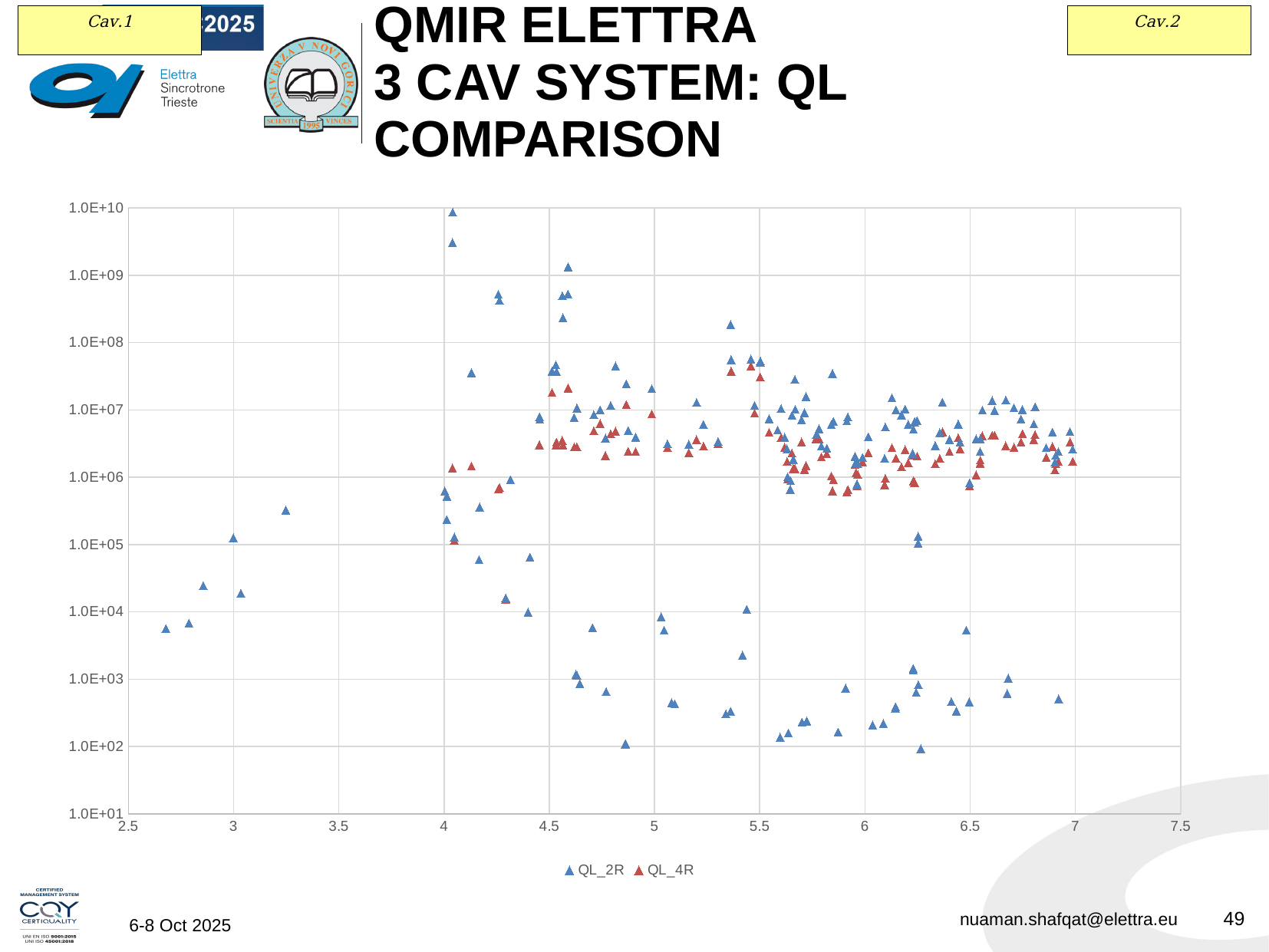
Which series reaches the highest plotted value on the chart? QL_2R What is the maximum value shown on the y axis? 1.0E+10 What kind of chart is shown on the slide? Scatter chart What is the range of the x axis? 2.5 to 7.5 How many series does the legend list? 2 Is the lowest QL_2R value greater or less than 1.0E+03? less Is the highest QL_2R value greater or less than 1.0E+09? greater Which colour marks the QL_4R series? Red What are the names of the two series in the legend? QL_2R and QL_4R